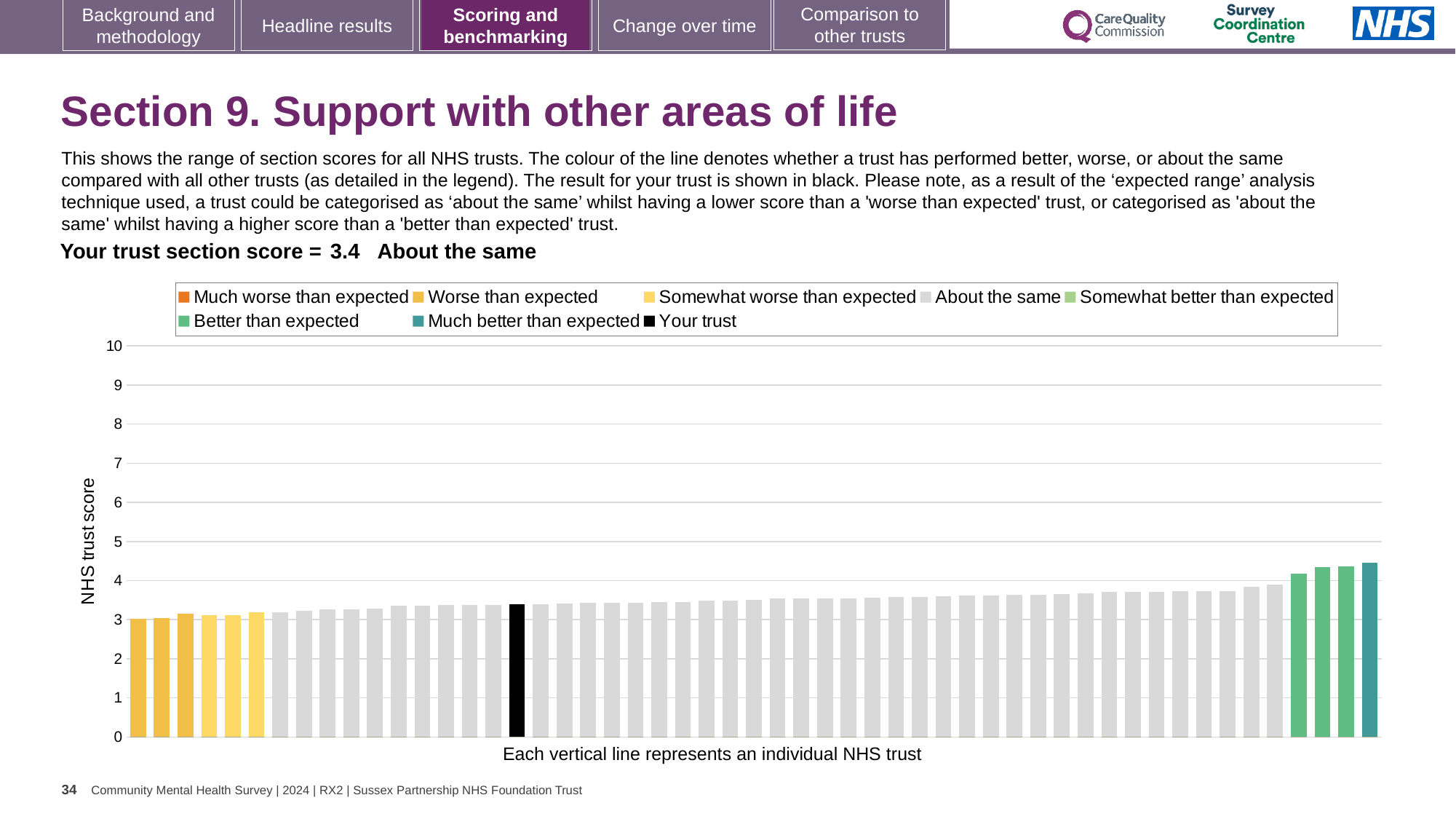
How many entries does the chart legend list? 8 Is the value of the black 'Your trust' bar greater or less than 4? less Is the tallest bar in the chart greater or less than 4? greater Do the bar values rise or fall from left to right along the x axis? rise How many bars are coloured as 'Much better than expected' (teal)? 1 Is the shortest bar in the chart greater or less than 2? greater How many bars are coloured as 'Better than expected' (green)? 3 What is the label on the vertical axis of the chart? NHS trust score What is the section score for your trust shown on the slide? 3.4 What colour is the bar representing your trust? black What kind of chart is shown on the slide? bar chart